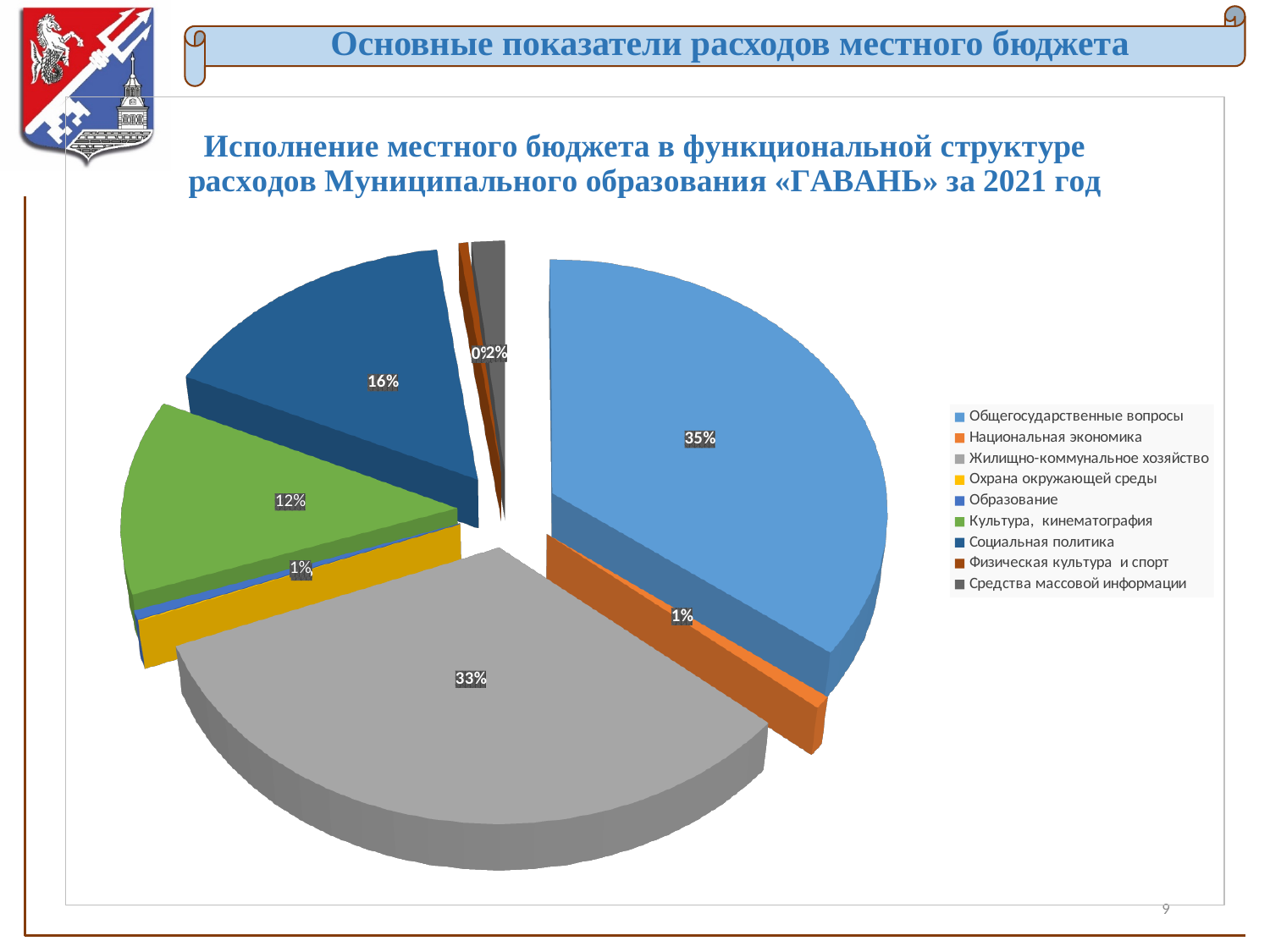
Which category has the largest share of the pie? Общегосударственные вопросы What share of the pie does «Культура, кинематография» have? 12% Which has the larger share: «Социальная политика» or «Культура, кинематография»? Социальная политика What share of the pie does «Жилищно-коммунальное хозяйство» have? 33% What share of the pie does «Средства массовой информации» have? 2% How many categories does the legend of the pie chart list? 9 What share of the pie does «Общегосударственные вопросы» have? 35% What is the difference in percentage points between «Социальная политика» and «Культура, кинематография»? 4% What share of the pie does «Физическая культура и спорт» have? 0% What kind of chart is shown on the slide? pie chart What share of the pie does «Национальная экономика» have? 1% What share of the pie does «Социальная политика» have? 16%